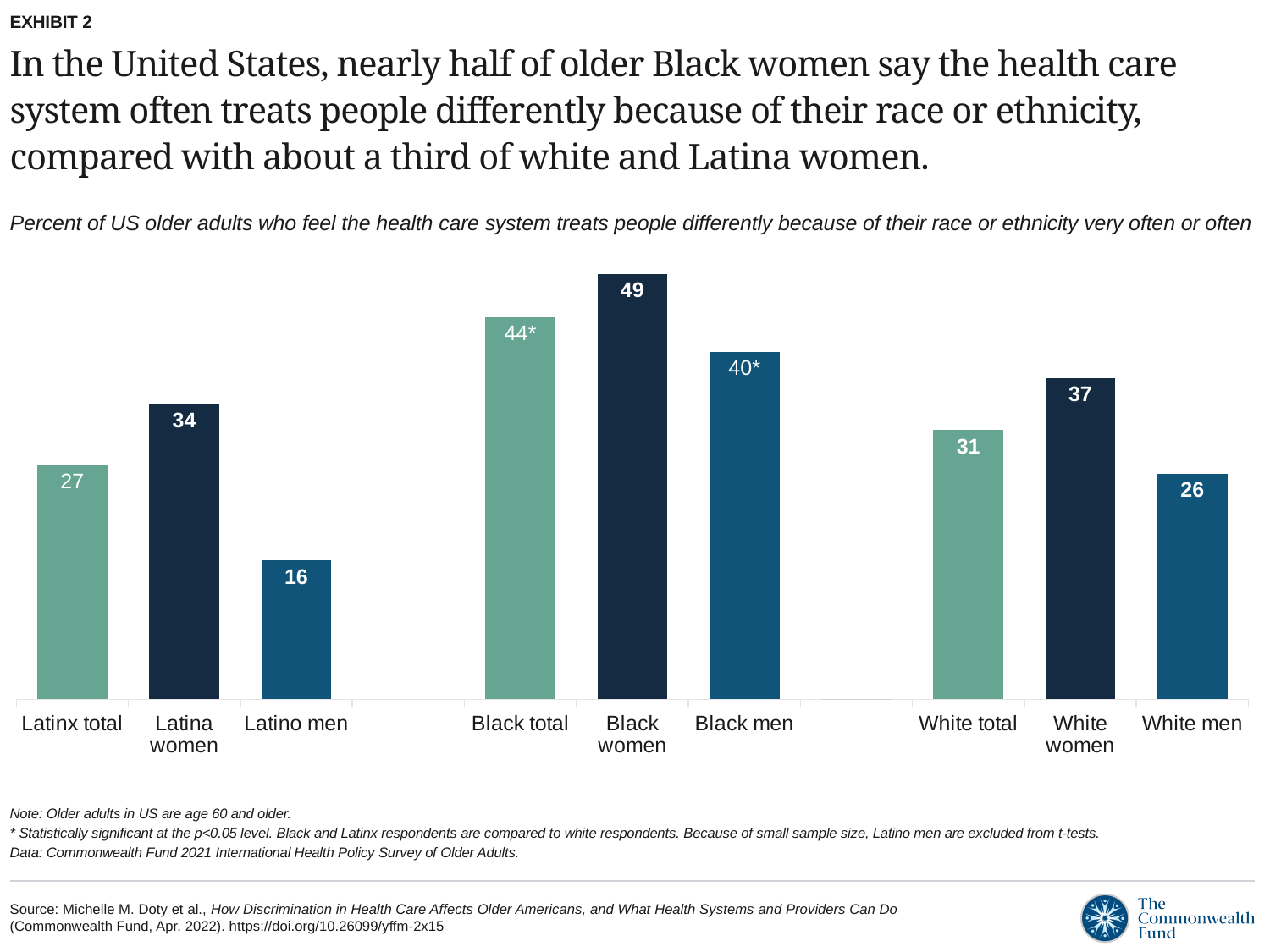
What is the exhibit number shown at the top of the slide? Exhibit 2 What is the difference between the values for Black women and White women? 12 Which category has the highest value? Black women What kind of chart is this? Bar chart Which category has the lowest value? Latino men Which is larger, the value for White men or the value for Latinx total? White men What is the value for Latino men? 16 What is the value for White total? 31 What is the value shown for Black total? 44* What is the difference between the values for Latina women and Latino men? 18 How many categories are shown on the x axis? 9 What is the value for Black women? 49